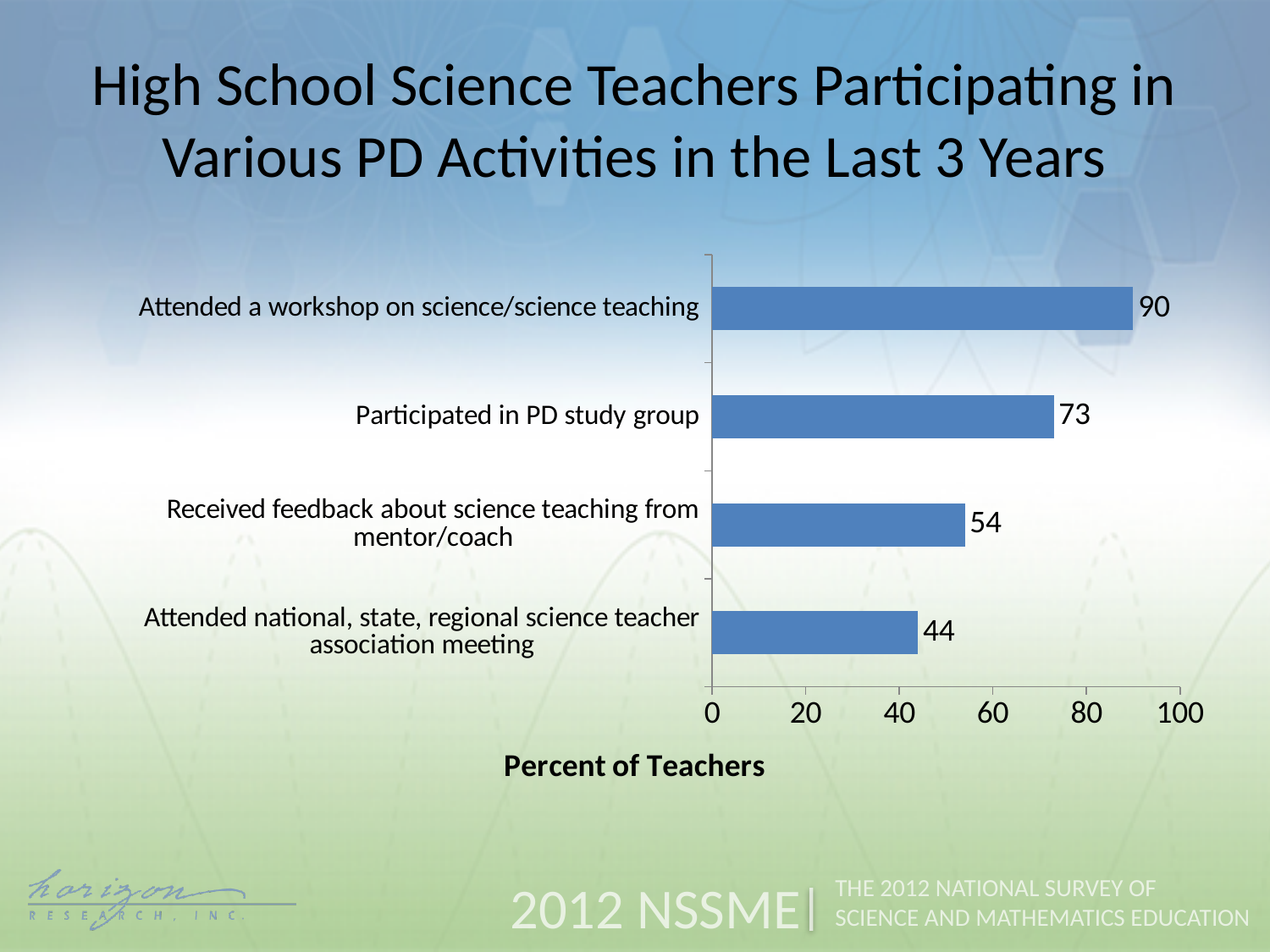
What percent of high school science teachers participated in a PD study group? 73 What is the difference in percent of teachers between receiving feedback from a mentor/coach and attending a science teacher association meeting? 10 What percent of high school science teachers attended a national, state, or regional science teacher association meeting? 44 Which PD activity has the highest percent of teachers participating? Attended a workshop on science/science teaching What percent of high school science teachers received feedback about science teaching from a mentor/coach? 54 What is the difference in percent of teachers between attending a workshop and participating in a PD study group? 17 Which PD activity has the lowest percent of teachers participating? Attended national, state, regional science teacher association meeting What is the label of the horizontal axis of the chart? Percent of Teachers How many PD activities are shown in the chart? 4 Which has a larger percent of teachers: participating in a PD study group or receiving feedback from a mentor/coach? Participated in PD study group What percent of high school science teachers attended a workshop on science/science teaching? 90 What type of chart is shown on the slide? Bar chart